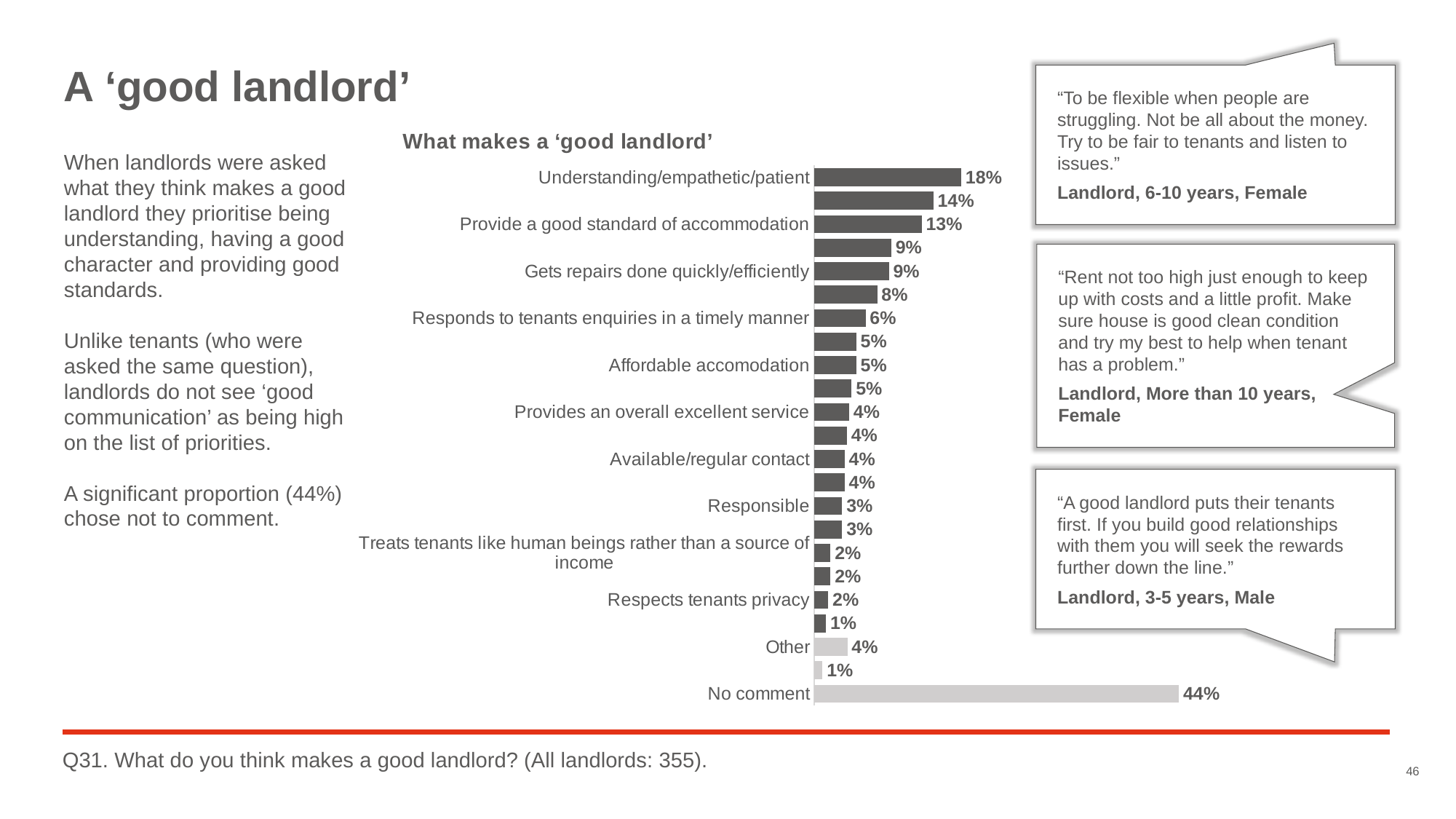
What is the value for Gets repairs done quickly/efficiently? 9% Which is larger, Responds to tenants enquiries in a timely manner or Affordable accomodation? Responds to tenants enquiries in a timely manner What is the value for Responds to tenants enquiries in a timely manner? 6% What kind of chart is shown on the slide? Bar chart What is the value for Respects tenants privacy? 2% What is the difference between Understanding/empathetic/patient and Provide a good standard of accommodation? 5 percentage points What percentage of landlords chose No comment? 44% What is the title of the chart? What makes a ‘good landlord’ What is the value for Provide a good standard of accommodation? 13% Excluding No comment and Other, which category has the highest value? Understanding/empathetic/patient Which category has the highest value in the chart? No comment What is the value for Understanding/empathetic/patient? 18%